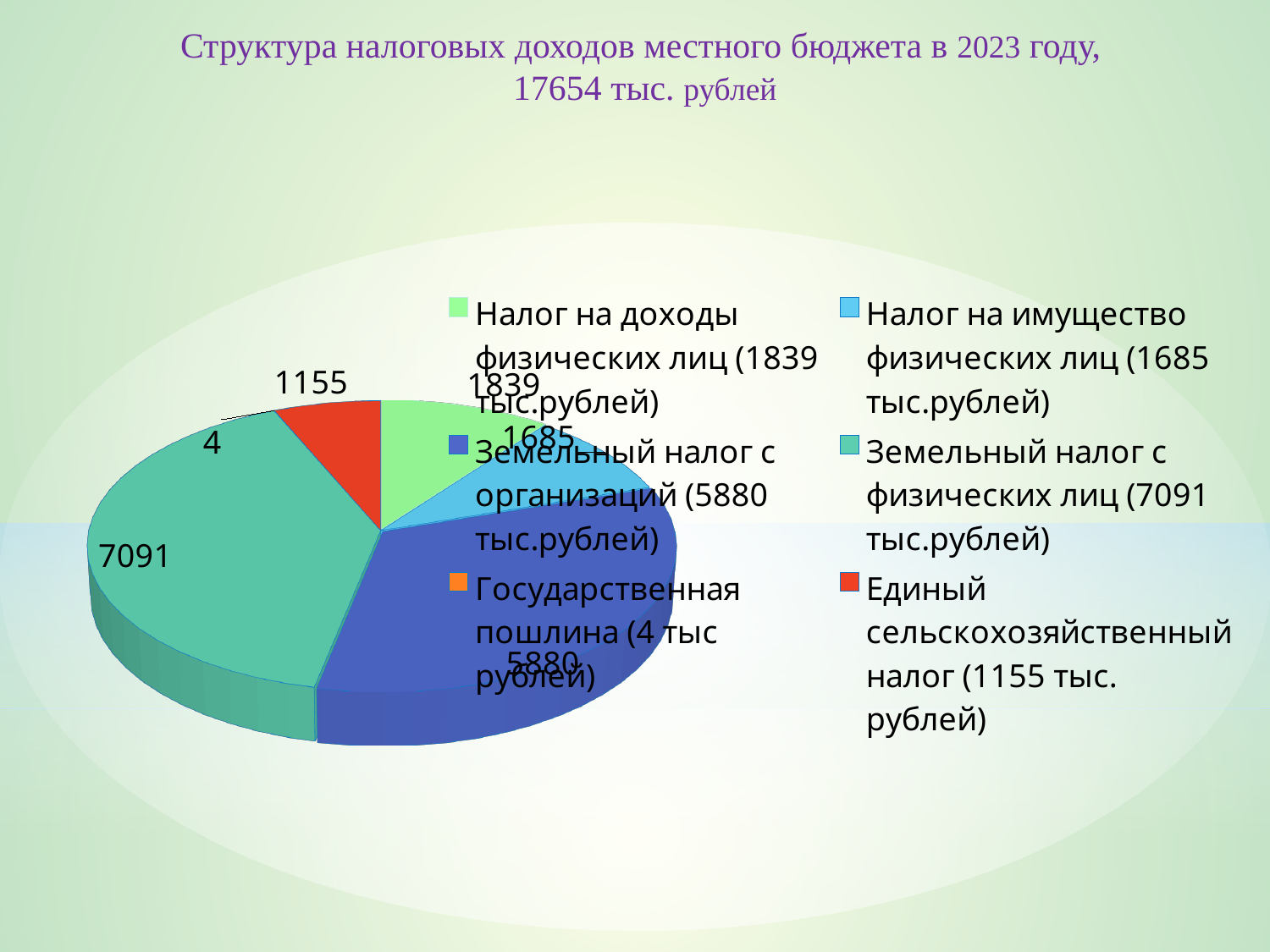
What type of chart is shown on the slide? Pie chart What is the difference between Земельный налог с физических лиц and Земельный налог с организаций? 1211 Which category has the largest slice of the pie? Земельный налог с физических лиц What is the value for Земельный налог с физических лиц? 7091 What is the value for Государственная пошлина? 4 What colour is the slice for Единый сельскохозяйственный налог? Red What is the value for Налог на доходы физических лиц? 1839 What is the total of all slices in the pie chart? 17654 What is the value for Единый сельскохозяйственный налог? 1155 How many categories does the pie chart have? 6 Which is larger: Налог на доходы физических лиц or Налог на имущество физических лиц? Налог на доходы физических лиц Which category has the smallest slice of the pie? Государственная пошлина